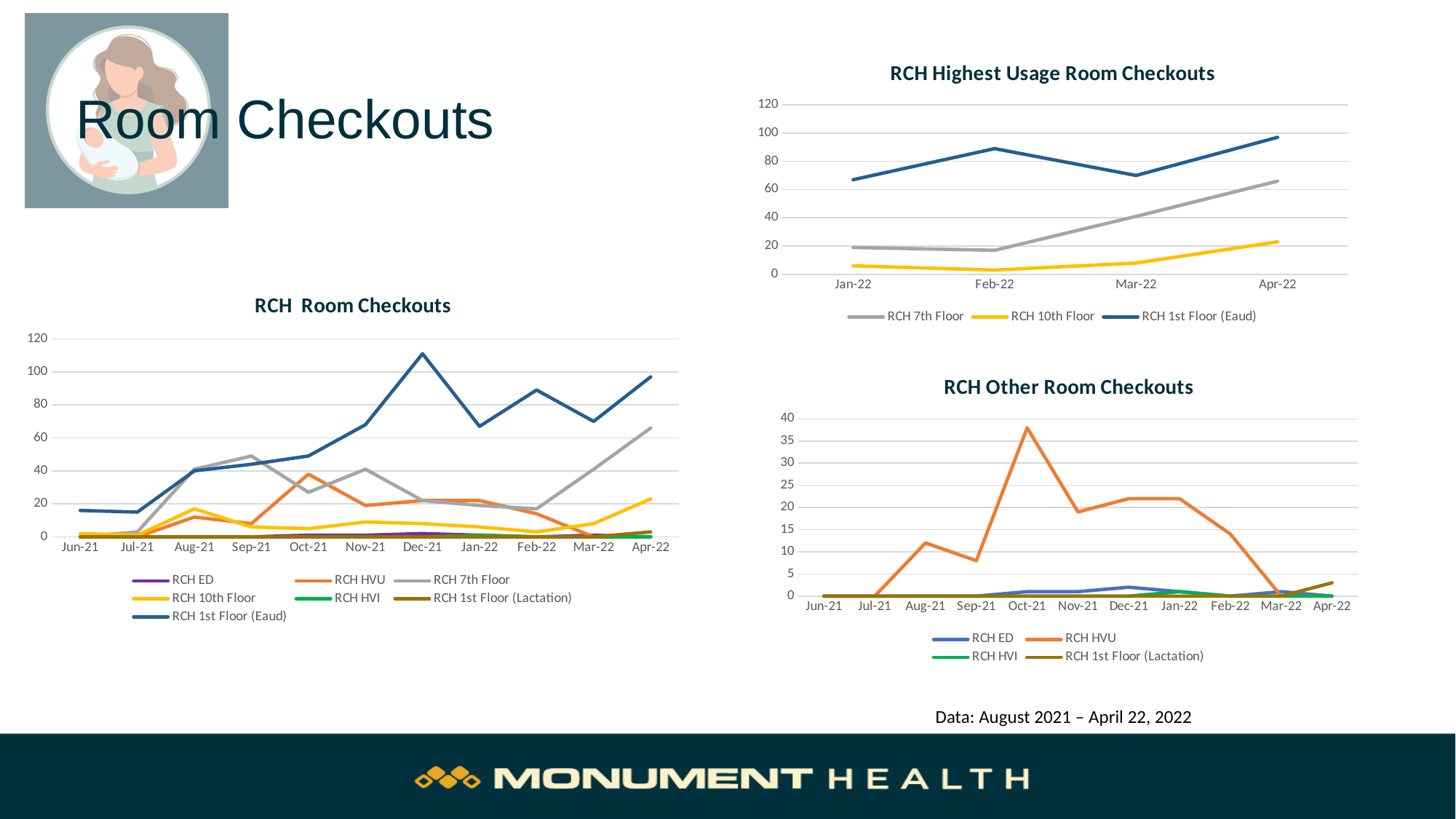
In the "RCH Other Room Checkouts" chart, is the value for RCH HVU in Oct-21 greater or less than 30? greater In the "RCH Other Room Checkouts" chart, in which month does RCH HVU reach its highest value? Oct-21 In the "RCH Highest Usage Room Checkouts" chart, which series has the highest value in Apr-22? RCH 1st Floor (Eaud) In the "RCH Highest Usage Room Checkouts" chart, does the RCH 7th Floor line rise or fall from Feb-22 to Apr-22? rise How many series does the legend of the "RCH Other Room Checkouts" chart list? 4 How many months are shown on the x axis of the "RCH Other Room Checkouts" chart? 11 How many months are shown on the x axis of the "RCH Highest Usage Room Checkouts" chart? 4 In the "RCH Highest Usage Room Checkouts" chart, is the value for RCH 7th Floor in Jan-22 greater or less than 40? less In the "RCH Highest Usage Room Checkouts" chart, is the value for RCH 1st Floor (Eaud) in Apr-22 greater or less than 80? greater How many series does the legend of the "RCH Room Checkouts" chart list? 7 What kind of chart is the "RCH Highest Usage Room Checkouts" chart? line chart In the "RCH Room Checkouts" chart, in which month does RCH 1st Floor (Eaud) reach its highest value? Dec-21